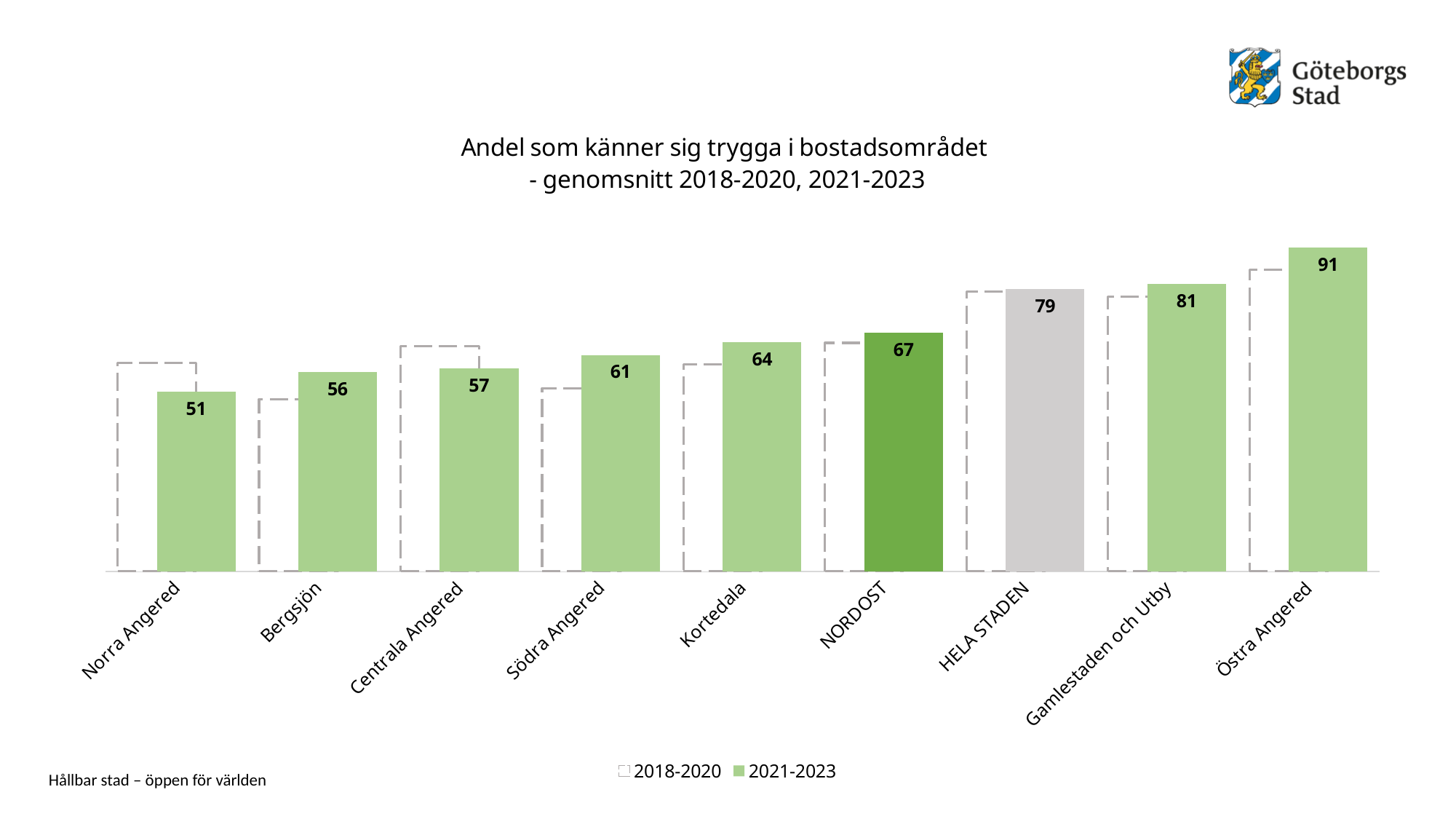
Which category has the lowest 2021-2023 value? Norra Angered For Södra Angered, which period has the higher value, 2018-2020 or 2021-2023? 2021-2023 How many categories are shown on the x axis? 9 What type of chart is shown on the slide? bar chart Which category has the highest 2021-2023 value? Östra Angered What is the difference between the 2021-2023 values for Östra Angered and NORDOST? 24 What is the difference between the 2021-2023 values for Gamlestaden och Utby and HELA STADEN? 2 What is the 2021-2023 value for HELA STADEN? 79 How many series does the legend list? 2 For Norra Angered, which period has the higher value, 2018-2020 or 2021-2023? 2018-2020 What is the 2021-2023 value for Norra Angered? 51 What is the 2021-2023 value for Kortedala? 64